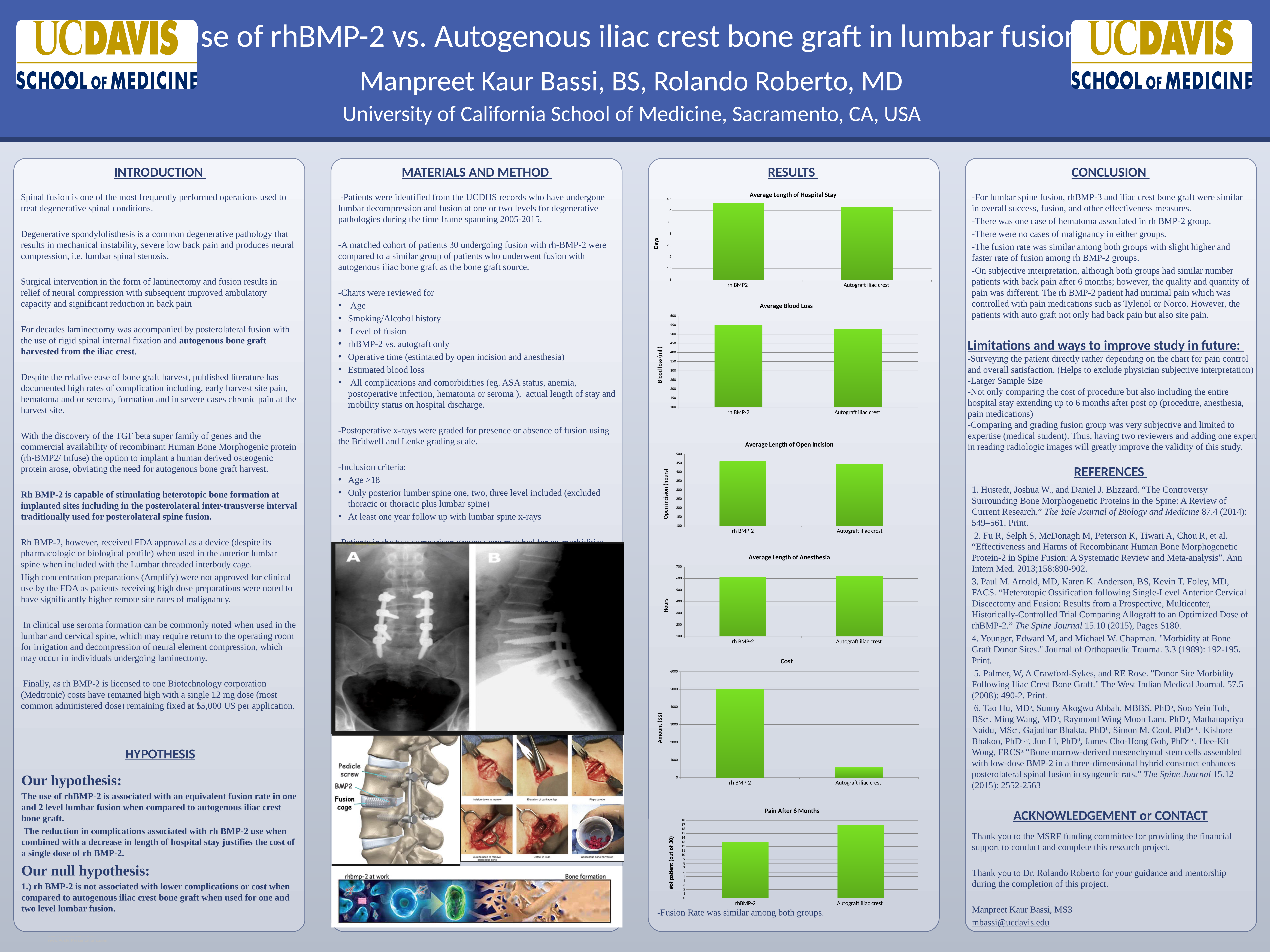
In the Average Length of Open Incision chart, which is larger, rh BMP-2 or Autograft iliac crest? rh BMP-2 What kind of chart is the Average Blood Loss chart? bar chart In the Pain After 6 Months chart, what is the difference between Autograft iliac crest and rhBMP-2? 4 In the Cost chart, what is the value for rh BMP-2? 5000 In the Pain After 6 Months chart, which category has the lowest value? rhBMP-2 In the Pain After 6 Months chart, what is the value for rhBMP-2? 13 How many categories does the Average Length of Anesthesia chart show? 2 In the Cost chart, which category has the highest value? rh BMP-2 In the Cost chart, is the value for Autograft iliac crest greater or less than 1000? less In the Average Length of Hospital Stay chart, is the value for Autograft iliac crest greater or less than 4? greater In the Average Blood Loss chart, is the value for rh BMP-2 greater or less than 500? greater In the Pain After 6 Months chart, what is the value for Autograft iliac crest? 17